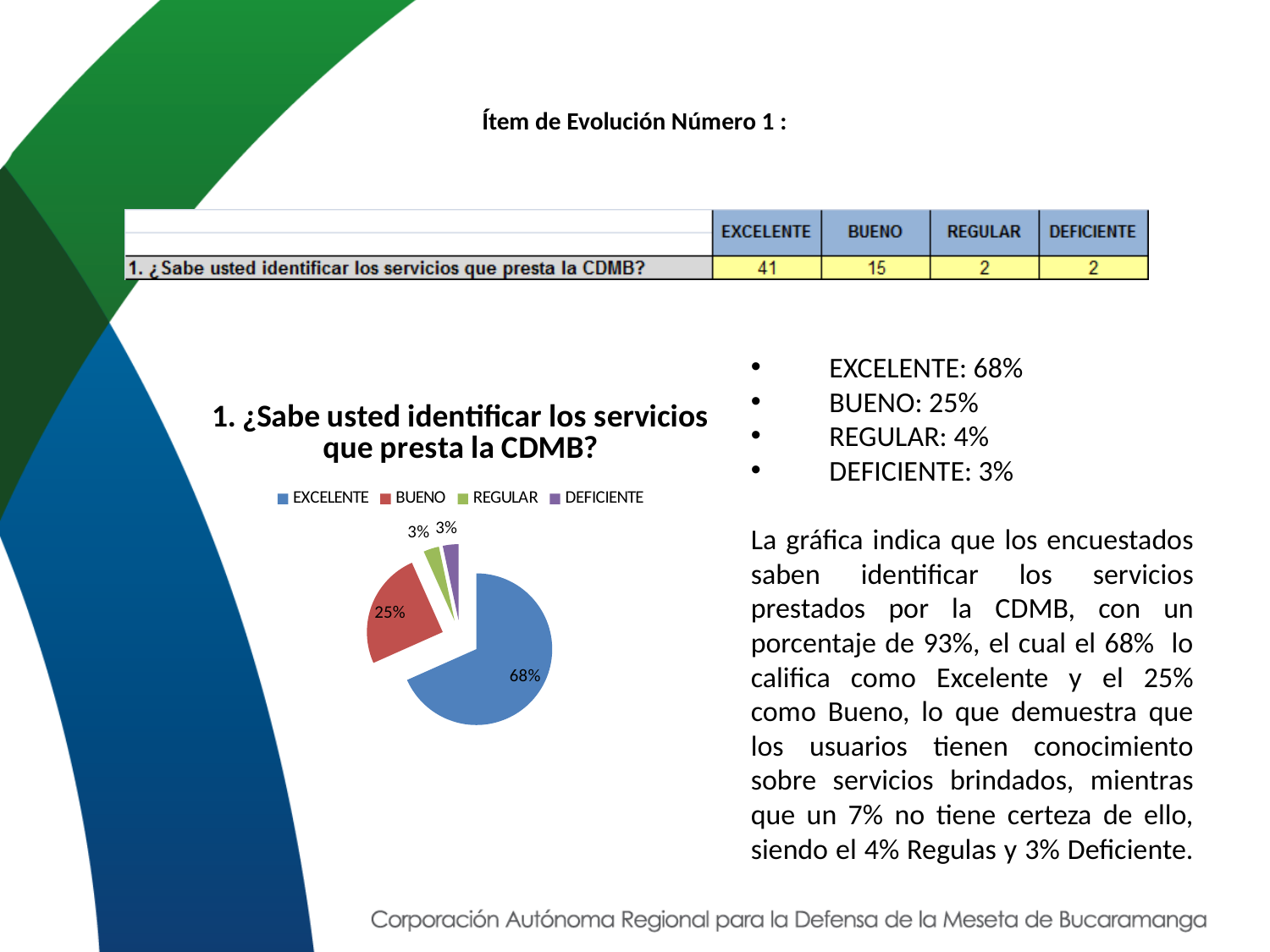
Which slice is larger in the pie chart, BUENO or REGULAR? BUENO What percentage does the EXCELENTE slice show in the pie chart? 68% What colour is the EXCELENTE slice in the pie chart? Blue How many slices does the pie chart have? 4 What is the combined share of the EXCELENTE and BUENO slices in the pie chart? 93% Which slice is larger in the pie chart, EXCELENTE or BUENO? EXCELENTE What is the title of the pie chart? 1. ¿Sabe usted identificar los servicios que presta la CDMB? What kind of chart is shown on the slide? Pie chart What percentage does the BUENO slice show in the pie chart? 25% Which category has the largest slice in the pie chart? EXCELENTE How many entries does the pie chart's legend list? 4 What is the difference in percentage points between the EXCELENTE and BUENO slices in the pie chart? 43